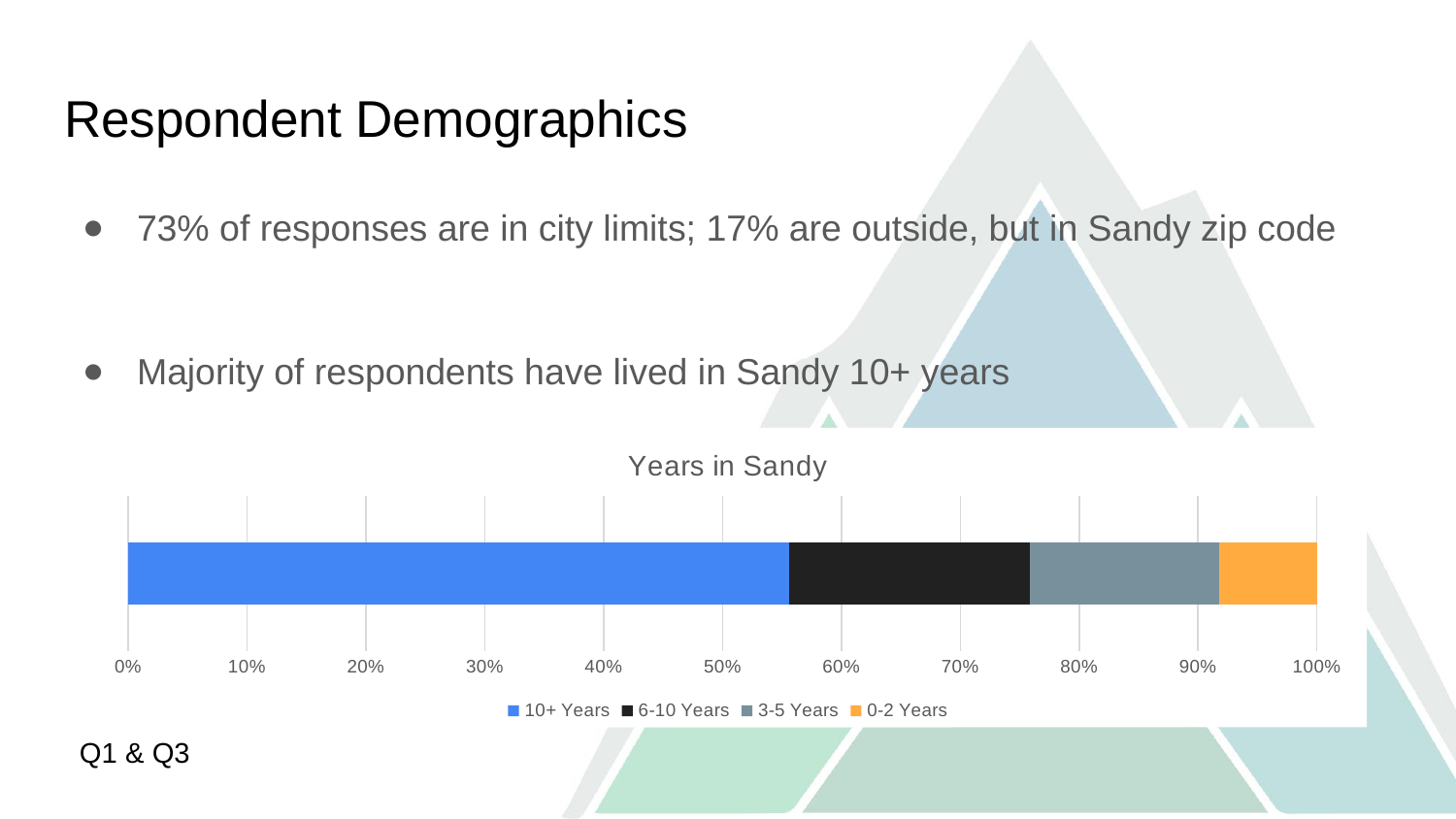
How many series does the legend of the "Years in Sandy" chart list? 4 Which series takes up the smallest share of the bar in the "Years in Sandy" chart? 0-2 Years What kind of chart is the "Years in Sandy" chart? Stacked bar chart Which series takes up the largest share of the bar in the "Years in Sandy" chart? 10+ Years In the "Years in Sandy" chart, which is larger: the share for 3-5 Years or the share for 0-2 Years? 3-5 Years What colour represents the 0-2 Years series in the "Years in Sandy" chart? Orange In the "Years in Sandy" chart, is the share for 6-10 Years greater or less than 10%? greater In the "Years in Sandy" chart, is the share for 10+ Years greater or less than 50%? greater What is the title of the chart on the slide? Years in Sandy In the "Years in Sandy" chart, which is larger: the share for 10+ Years or the share for 6-10 Years? 10+ Years In the "Years in Sandy" chart, is the share for 0-2 Years greater or less than 10%? less What value does the full stacked bar in the "Years in Sandy" chart reach on the axis? 100%